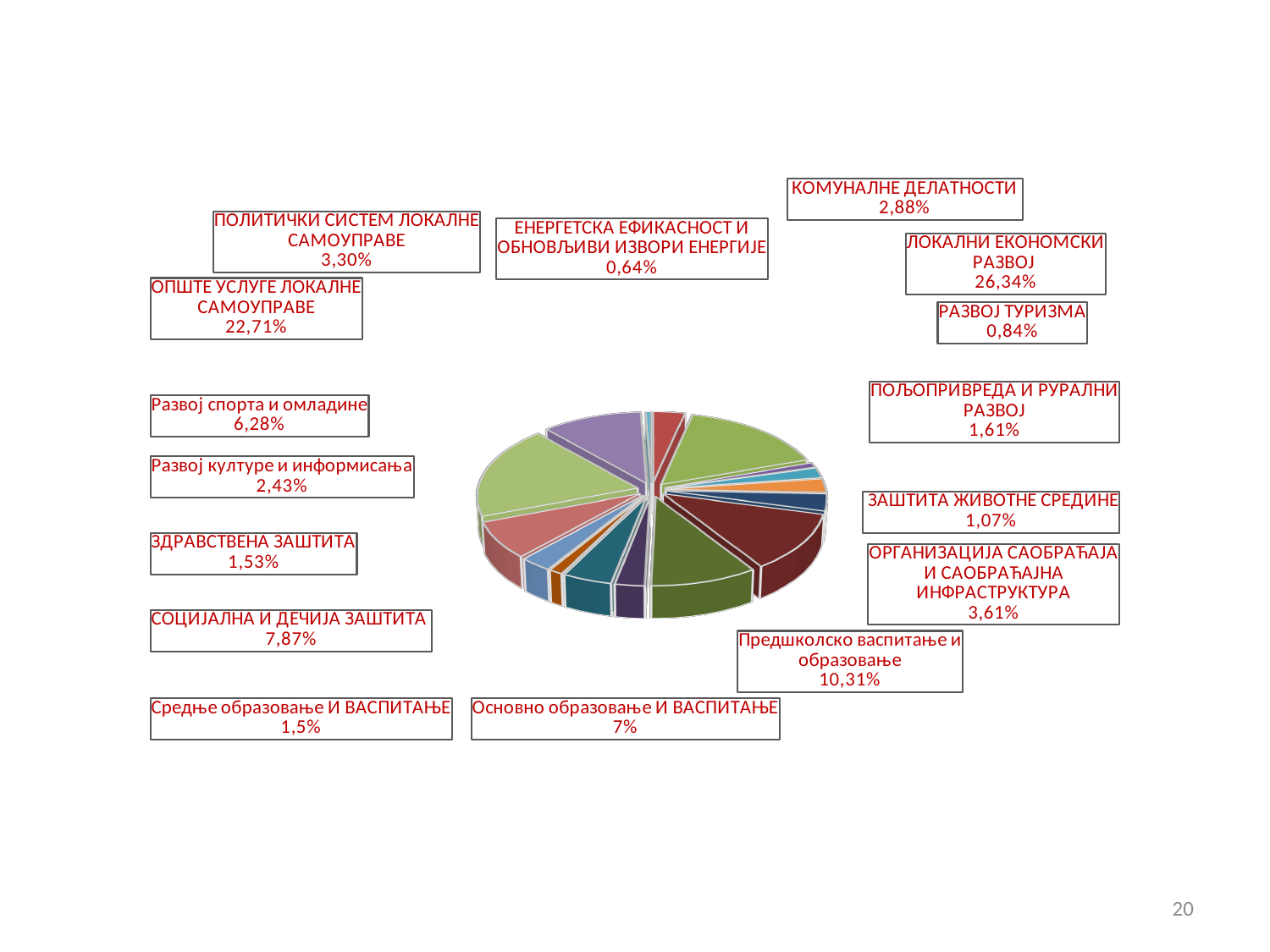
Which category has the smallest share of the pie? ЕНЕРГЕТСКА ЕФИКАСНОСТ И ОБНОВЉИВИ ИЗВОРИ ЕНЕРГИЈЕ What is the difference in percentage points between Предшколско васпитање и образовање and СОЦИЈАЛНА И ДЕЧИЈА ЗАШТИТА? 2,44 What share of the pie is ОПШТЕ УСЛУГЕ ЛОКАЛНЕ САМОУПРАВЕ? 22,71% What is the value shown for СОЦИЈАЛНА И ДЕЧИЈА ЗАШТИТА? 7,87% What is the difference in percentage points between ЛОКАЛНИ ЕКОНОМСКИ РАЗВОЈ and ОПШТЕ УСЛУГЕ ЛОКАЛНЕ САМОУПРАВЕ? 3,63 What is the value shown for ОРГАНИЗАЦИЈА САОБРАЋАЈА И САОБРАЋАЈНА ИНФРАСТРУКТУРА? 3,61% Which category has the largest share of the pie? ЛОКАЛНИ ЕКОНОМСКИ РАЗВОЈ What is the value shown for РАЗВОЈ ТУРИЗМА? 0,84% What kind of chart is shown on the slide? Pie chart How many categories are labelled on the pie chart? 16 Which is larger: Развој спорта и омладине or Основно образовање И ВАСПИТАЊЕ? Основно образовање И ВАСПИТАЊЕ What is the value shown for Предшколско васпитање и образовање? 10,31%